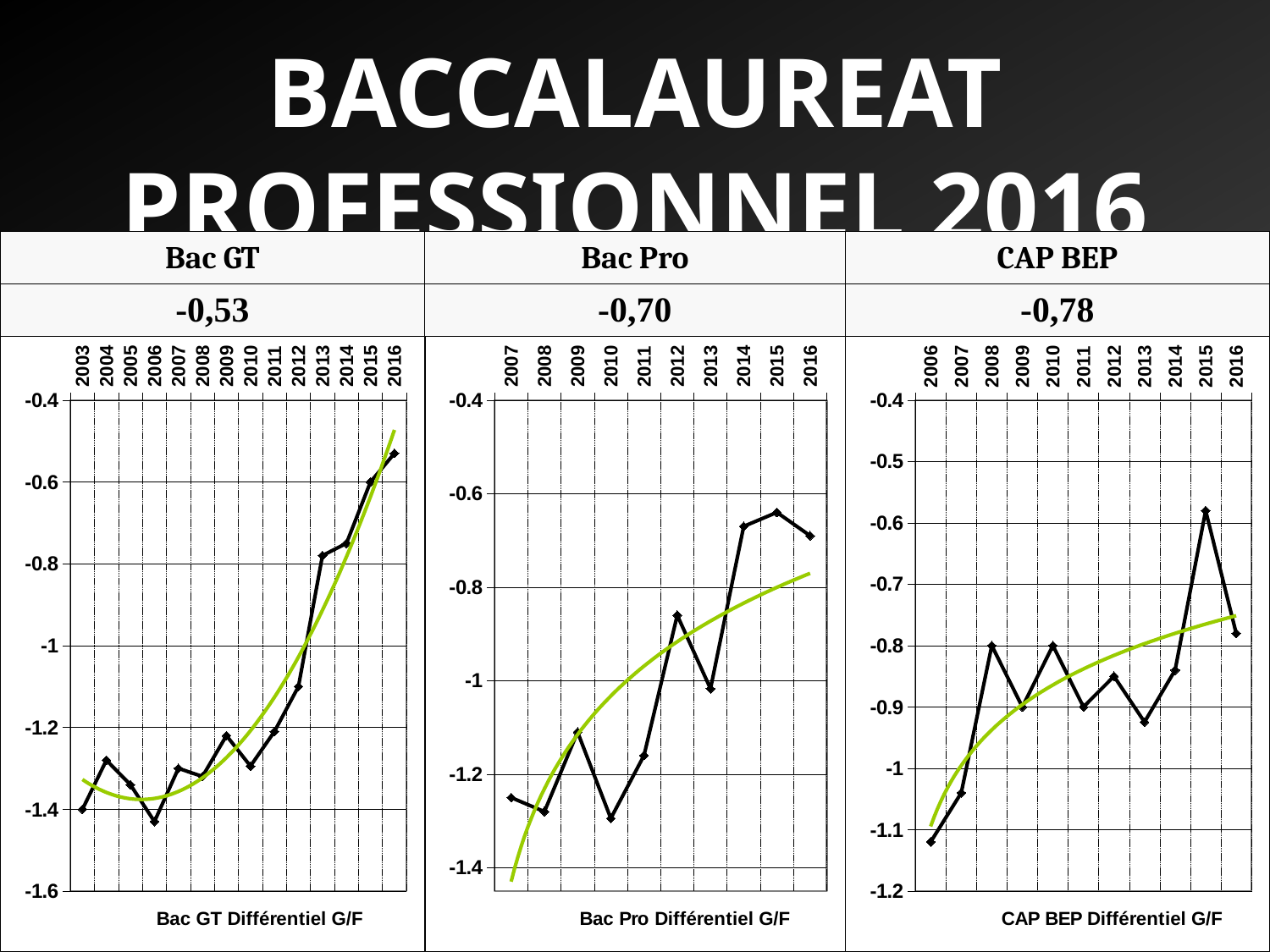
On the Bac GT chart, is the value for 2013 greater or less than -1? greater How many years are plotted on the CAP BEP chart? 11 On the CAP BEP chart, which year has the highest value? 2015 On the Bac Pro chart, is the value for 2010 greater or less than -1.2? less On the CAP BEP chart, which year has the lowest value? 2006 On the Bac GT chart, which year has the highest value? 2016 How many years are plotted on the Bac GT chart? 14 What value is printed in the table for Bac Pro? -0,70 What kind of chart is the Bac GT chart? line chart How many years are plotted on the Bac Pro chart? 10 On the Bac Pro chart, do the values generally rise or fall from 2007 to 2016? rise What value is printed in the table for CAP BEP? -0,78